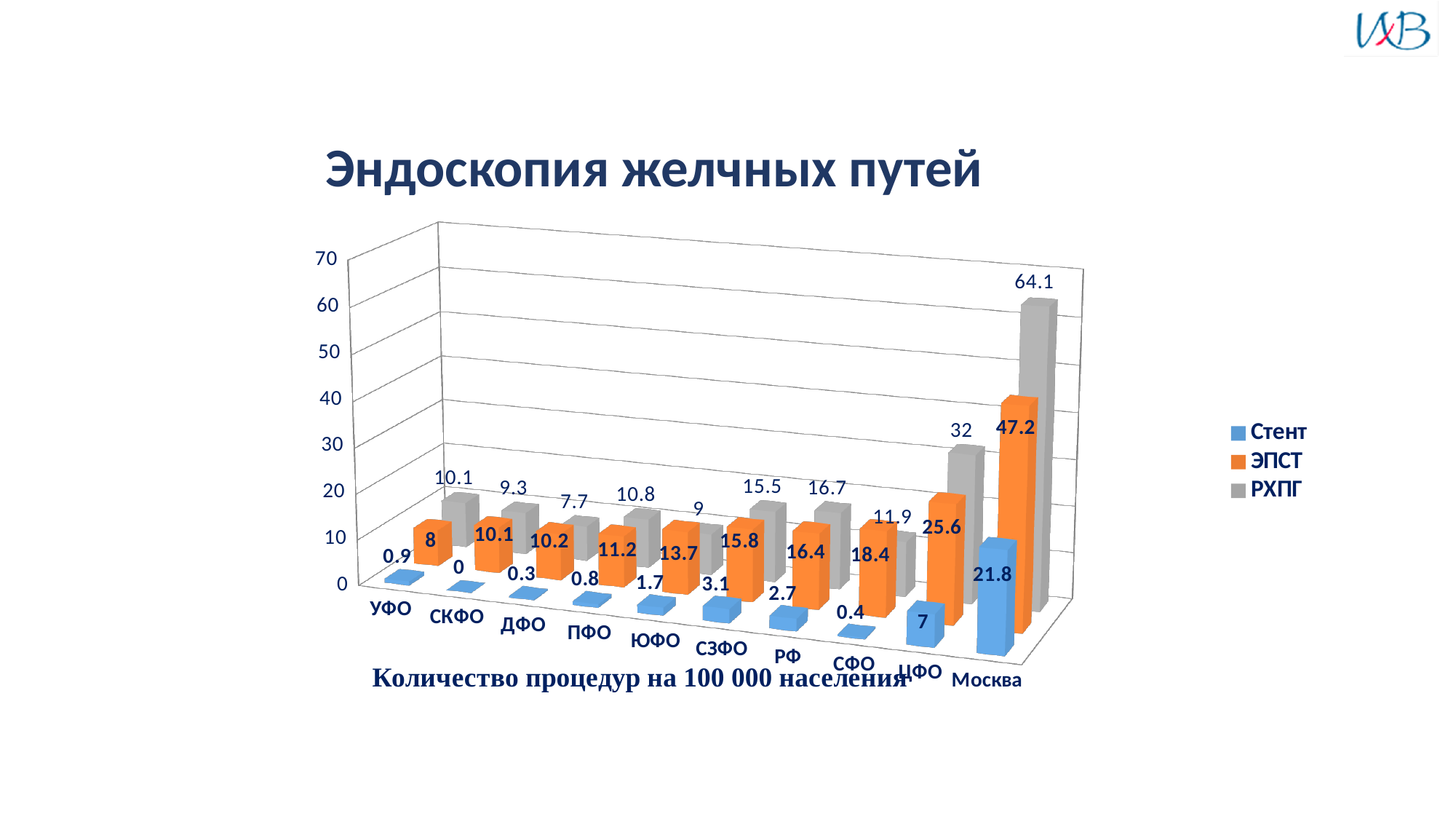
What is the Стент value for РФ? 2.7 What kind of chart is shown on the slide? Bar chart How many categories are shown on the x axis? 10 What is the difference between the ЭПСТ values for Москва and ЦФО? 21.6 What is the РХПГ value for Москва? 64.1 Which category has the lowest Стент value? СКФО For СФО, which is larger: the ЭПСТ value or the РХПГ value? ЭПСТ Which category has the lowest РХПГ value? ДФО How many series does the legend list? 3 What is the Стент value for СЗФО? 3.1 Which category has the highest РХПГ value? Москва What is the ЭПСТ value for ЦФО? 25.6